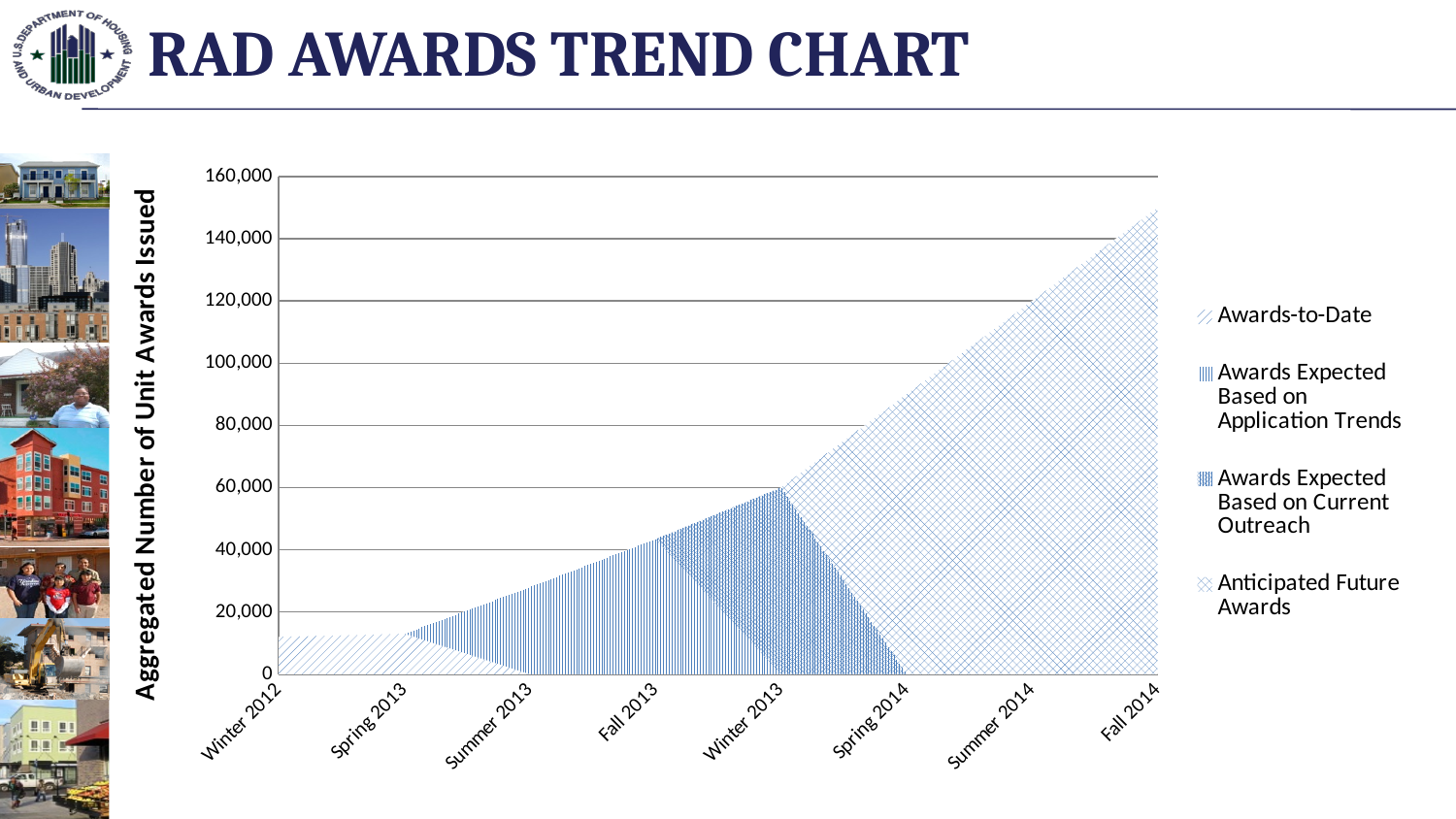
Do the aggregated unit awards rise or fall from Winter 2012 to Fall 2014? Rise Is the total aggregated value for Fall 2014 greater or less than 140,000? greater What is the label on the vertical axis? Aggregated Number of Unit Awards Issued What kind of chart is shown on the slide? Area chart Is the aggregated value for Winter 2012 greater or less than 20,000? less How many series does the legend list? 4 What is the title of the chart? RAD AWARDS TREND CHART Which period has the highest aggregated number of unit awards? Fall 2014 Which period has a larger aggregated value, Summer 2014 or Spring 2014? Summer 2014 Which period has a larger aggregated value, Fall 2013 or Winter 2012? Fall 2013 Is the total aggregated value for Summer 2014 greater or less than 100,000? greater How many time periods are shown along the x axis? 8